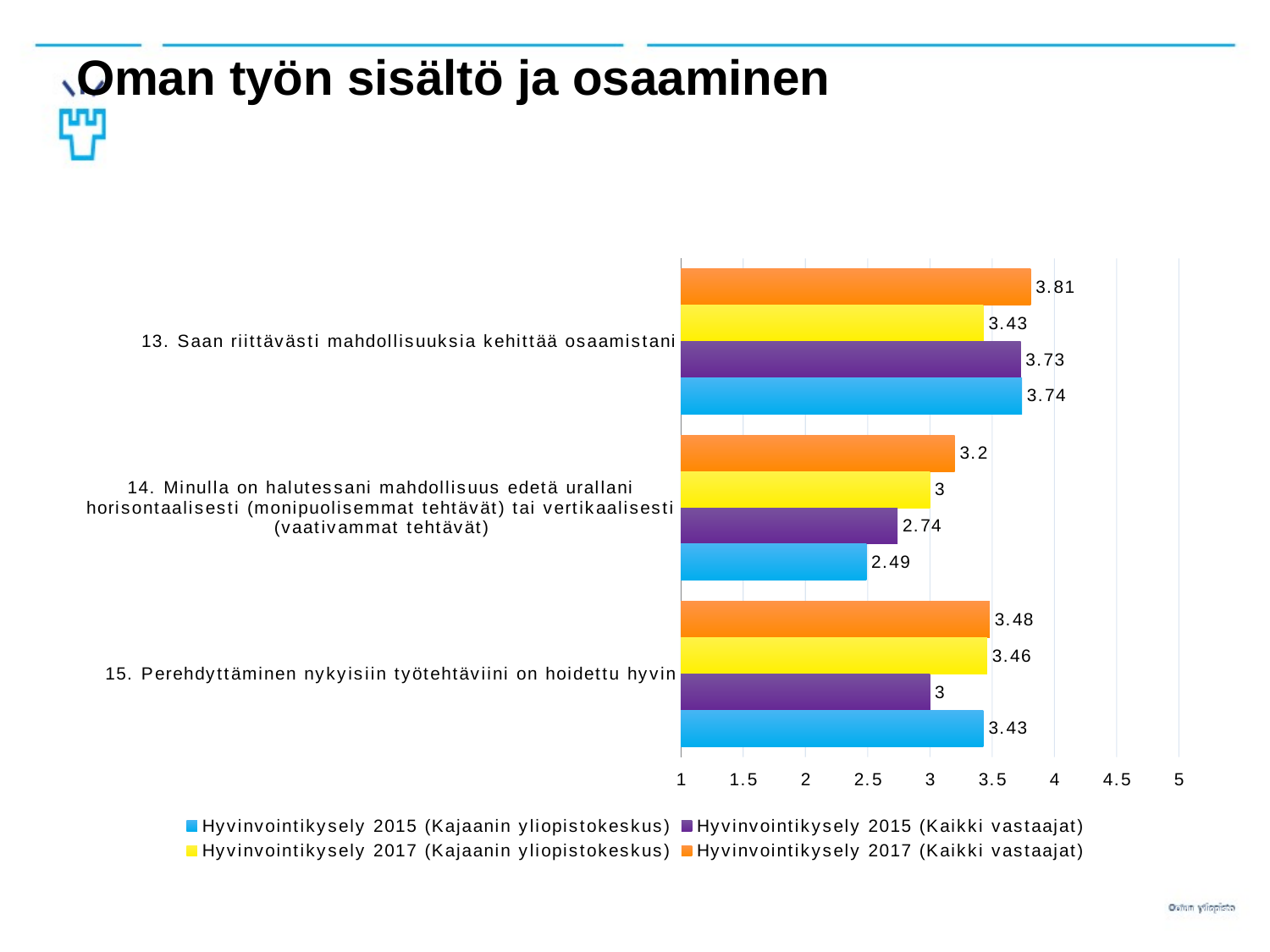
Which series has the highest value for statement 13 (Saan riittävästi mahdollisuuksia kehittää osaamistani)? Hyvinvointikysely 2017 (Kaikki vastaajat) How many categories (statements) are shown on the chart? 3 What is the value for Hyvinvointikysely 2017 (Kajaanin yliopistokeskus) for statement 15 (Perehdyttäminen nykyisiin työtehtäviini on hoidettu hyvin)? 3.46 What is the value for Hyvinvointikysely 2015 (Kajaanin yliopistokeskus) for statement 14 (Minulla on halutessani mahdollisuus edetä urallani)? 2.49 Is the Hyvinvointikysely 2015 (Kaikki vastaajat) value for statement 14 greater or less than 3? less What colour represents Hyvinvointikysely 2017 (Kajaanin yliopistokeskus) in the chart? yellow What is the value for Hyvinvointikysely 2017 (Kaikki vastaajat) for statement 13 (Saan riittävästi mahdollisuuksia kehittää osaamistani)? 3.81 Which series has the lowest value for statement 14 (Minulla on halutessani mahdollisuus edetä urallani)? Hyvinvointikysely 2015 (Kajaanin yliopistokeskus) What kind of chart is shown on the slide? bar chart How many series does the legend list? 4 For statement 15, which is larger: the Hyvinvointikysely 2015 (Kajaanin yliopistokeskus) value or the Hyvinvointikysely 2015 (Kaikki vastaajat) value? Hyvinvointikysely 2015 (Kajaanin yliopistokeskus) What is the difference between the Hyvinvointikysely 2017 (Kaikki vastaajat) and Hyvinvointikysely 2015 (Kajaanin yliopistokeskus) values for statement 14? 0.71